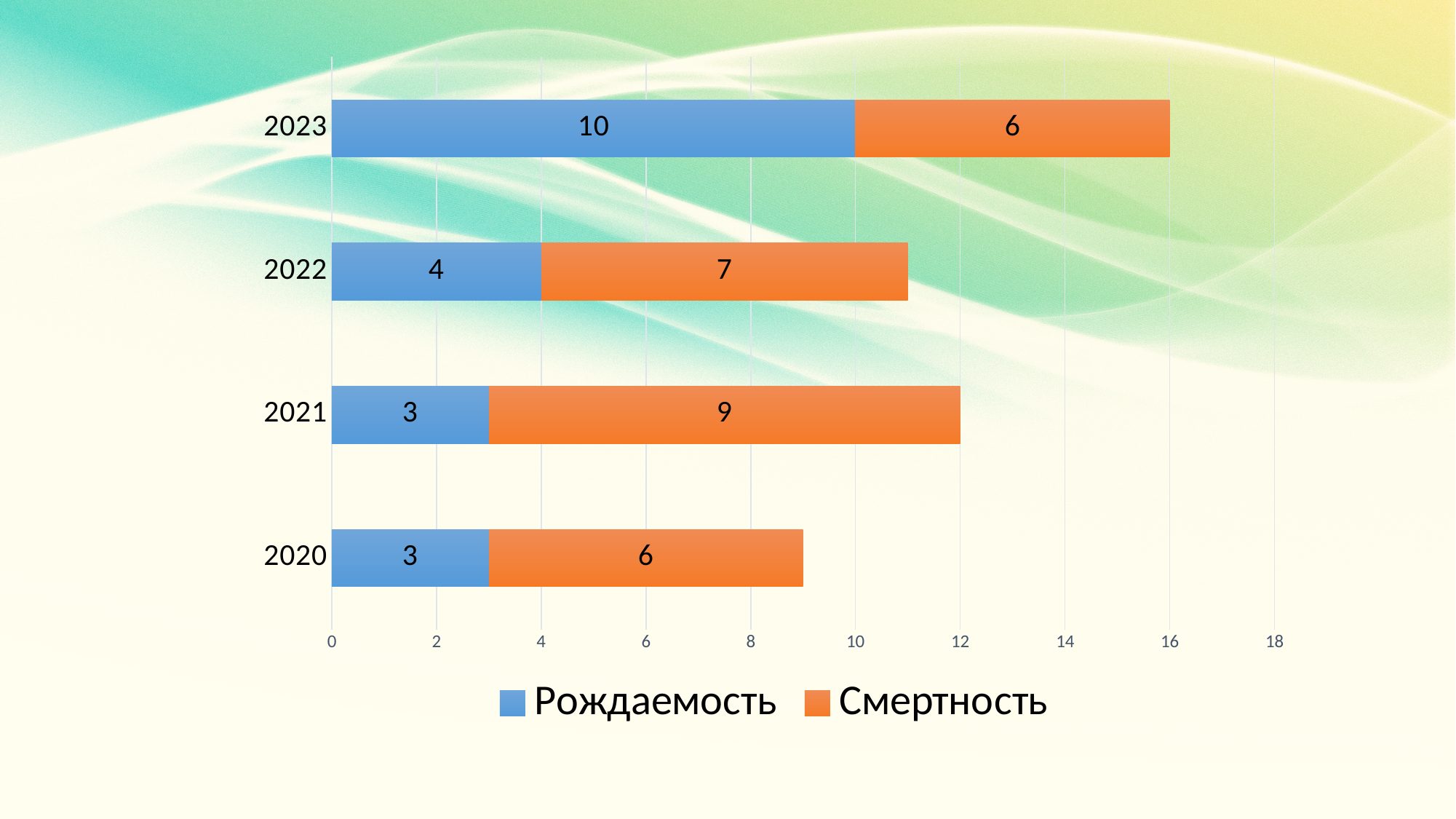
What is the Рождаемость value for 2023? 10 How many series does the legend list? 2 What is the total of the stacked bar for 2020? 9 Which year has the lowest Смертность value? 2020 and 2023 What kind of chart is shown on the slide? Stacked bar chart What is the total of the stacked bar for 2023? 16 What is the Смертность value for 2021? 9 Which year has the highest Рождаемость value? 2023 What is the Рождаемость value for 2022? 4 How many years are shown on the chart? 4 Which is larger in 2023, Рождаемость or Смертность? Рождаемость What is the difference between Смертность and Рождаемость in 2021? 6